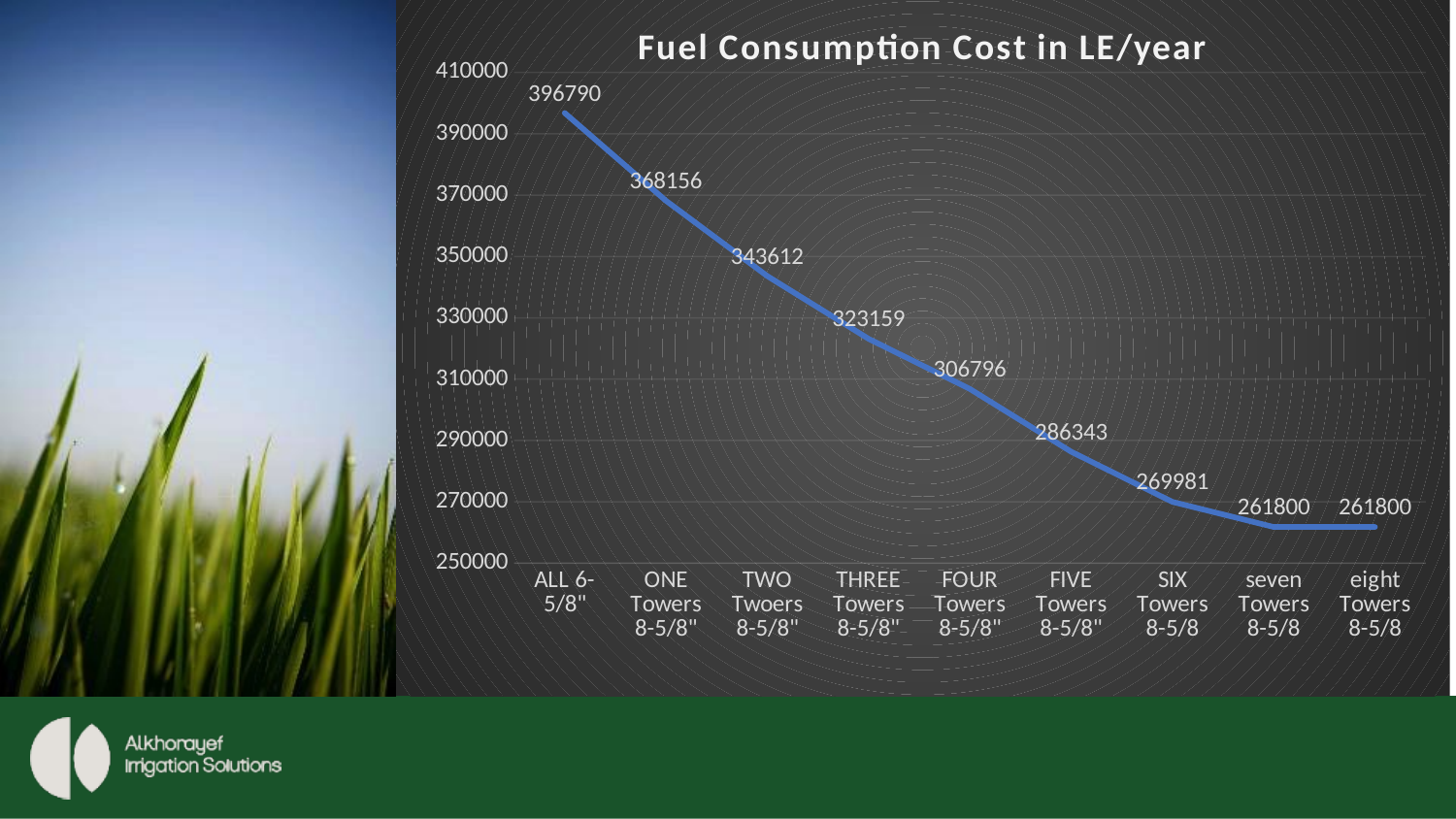
What is the fuel consumption cost for ALL 6-5/8"? 396790 What is the fuel consumption cost for THREE Towers 8-5/8"? 323159 Which has a higher fuel consumption cost, TWO Twoers 8-5/8" or FIVE Towers 8-5/8"? TWO Twoers 8-5/8" What is the lowest fuel consumption cost value shown on the chart? 261800 What is the difference in fuel consumption cost between ALL 6-5/8" and ONE Towers 8-5/8"? 28634 What kind of chart is shown on the slide? line chart Which category has the highest fuel consumption cost? ALL 6-5/8" What is the fuel consumption cost for SIX Towers 8-5/8? 269981 What is the difference in fuel consumption cost between FOUR Towers 8-5/8" and FIVE Towers 8-5/8"? 20453 Is the fuel consumption cost for FOUR Towers 8-5/8" greater or less than 310000? less How many categories are plotted on the x axis? 9 Do the fuel consumption cost values rise or fall from left to right along the x axis? fall